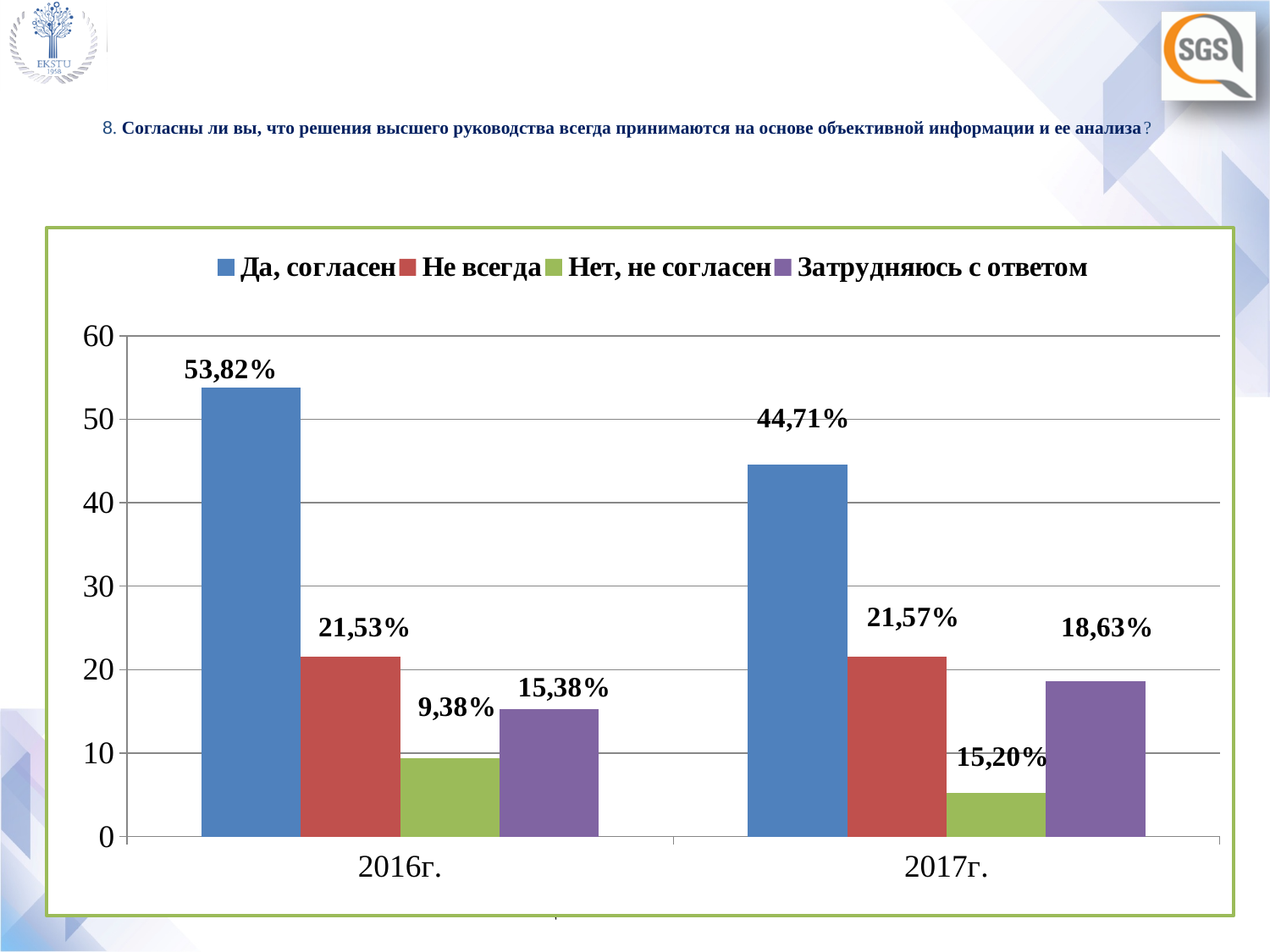
What is the value for "Не всегда" in 2017г.? 21,57% Is the value for "Да, согласен" in 2017г. greater or less than 40? greater What kind of chart is shown on the slide? Bar chart Which response has the lowest value in 2016г.? Нет, не согласен How many series does the legend list? 4 What is the difference between the "Да, согласен" values for 2016г. and 2017г.? 9,11% What is the value for "Да, согласен" in 2017г.? 44,71% Which response has the highest value in 2016г.? Да, согласен What is the value for "Да, согласен" in 2016г.? 53,82% What is the value for "Затрудняюсь с ответом" in 2017г.? 18,63% Which is larger: "Затрудняюсь с ответом" in 2016г. or in 2017г.? 2017г. What is the value for "Нет, не согласен" in 2016г.? 9,38%